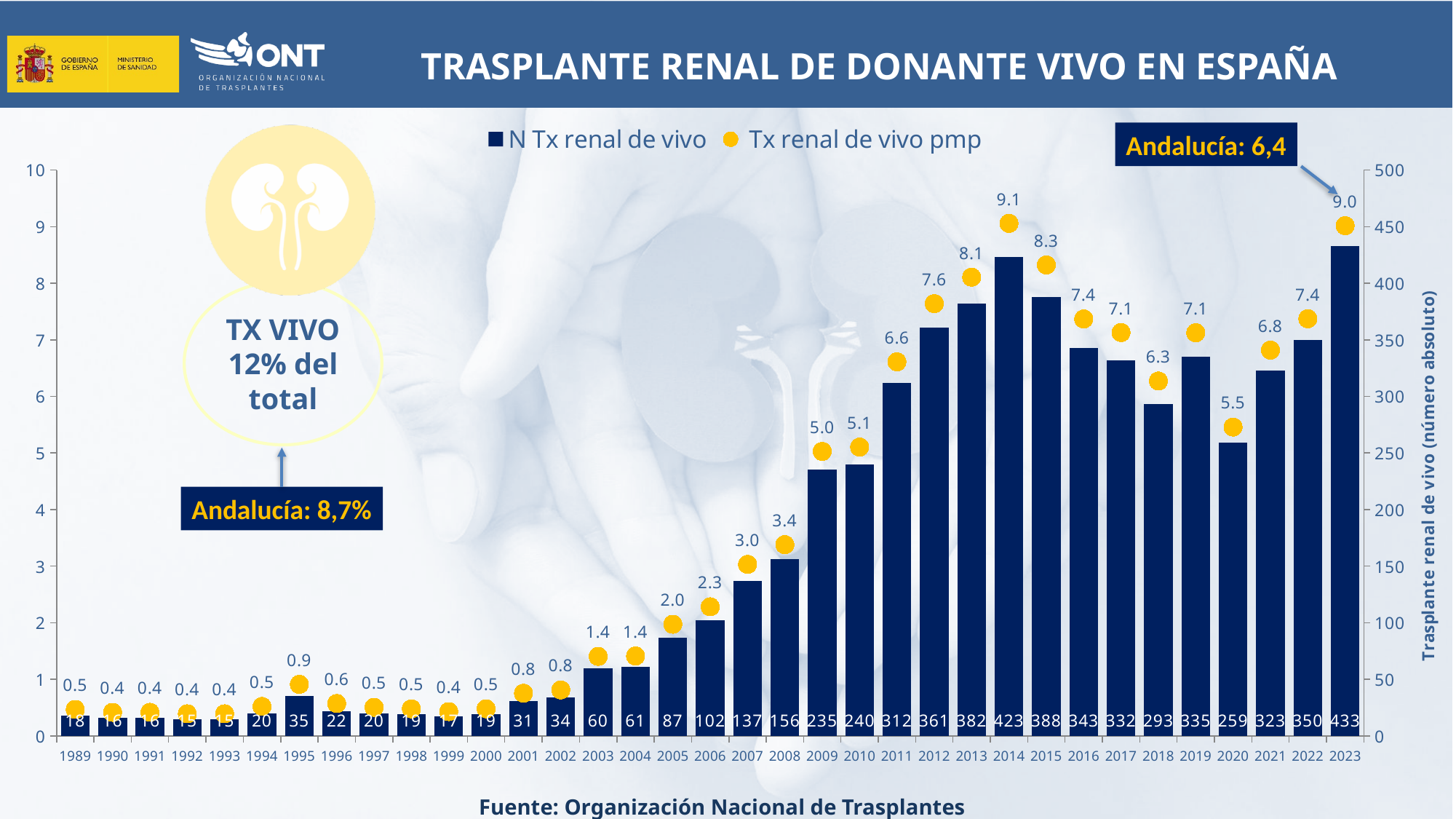
How many series does the legend list? 2 What kind of chart is used to show N Tx renal de vivo? Bar chart What is the title of the chart? TRASPLANTE RENAL DE DONANTE VIVO EN ESPAÑA What is the value of N Tx renal de vivo for 2023? 433 Which year has the highest Tx renal de vivo pmp value? 2014 Which year has a larger N Tx renal de vivo value, 2015 or 2016? 2015 How many years are shown on the x axis? 35 What is the value of N Tx renal de vivo for 2009? 235 What is the Tx renal de vivo pmp value for 2014? 9.1 What is the difference in Tx renal de vivo pmp between 2014 and 2020? 3.6 What is the difference in N Tx renal de vivo between 2023 and 2022? 83 Which year has the highest N Tx renal de vivo value? 2023